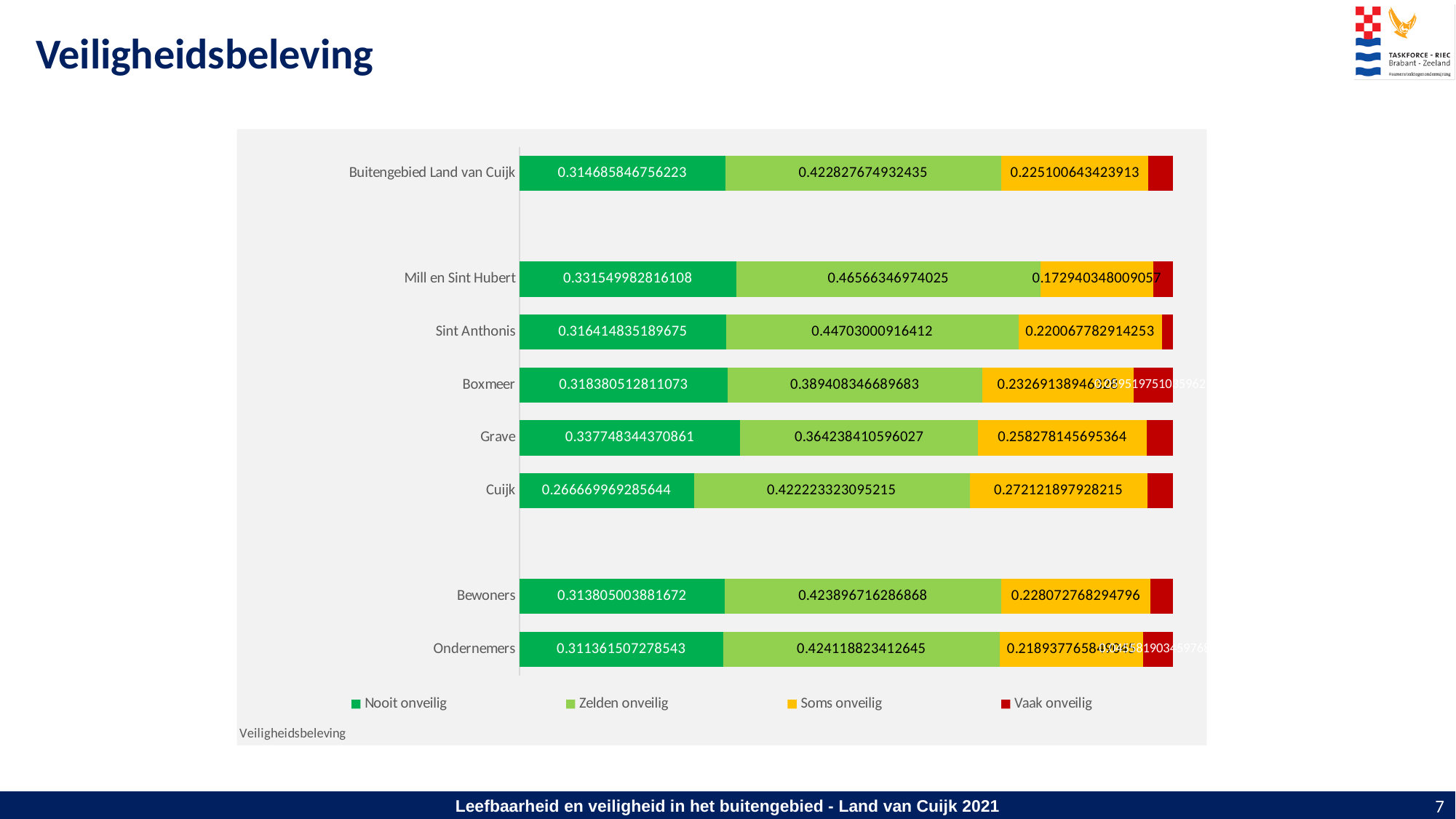
How many series does the legend list? 4 How many categories are shown on the y axis of the chart? 8 What is the Soms onveilig value for Cuijk? 0.272121897928215 What kind of chart is shown on the slide? Stacked bar chart What is the Zelden onveilig value for Mill en Sint Hubert? 0.46566346974025 What is the Nooit onveilig value for Bewoners? 0.313805003881672 Which category has the highest Zelden onveilig value? Mill en Sint Hubert What colour represents Vaak onveilig in the legend? Red Which category has the lowest Nooit onveilig value? Cuijk Which is larger, the Zelden onveilig value for Grave or for Cuijk? Cuijk Which category has the lowest Soms onveilig value? Mill en Sint Hubert What is the Nooit onveilig value for Grave? 0.337748344370861